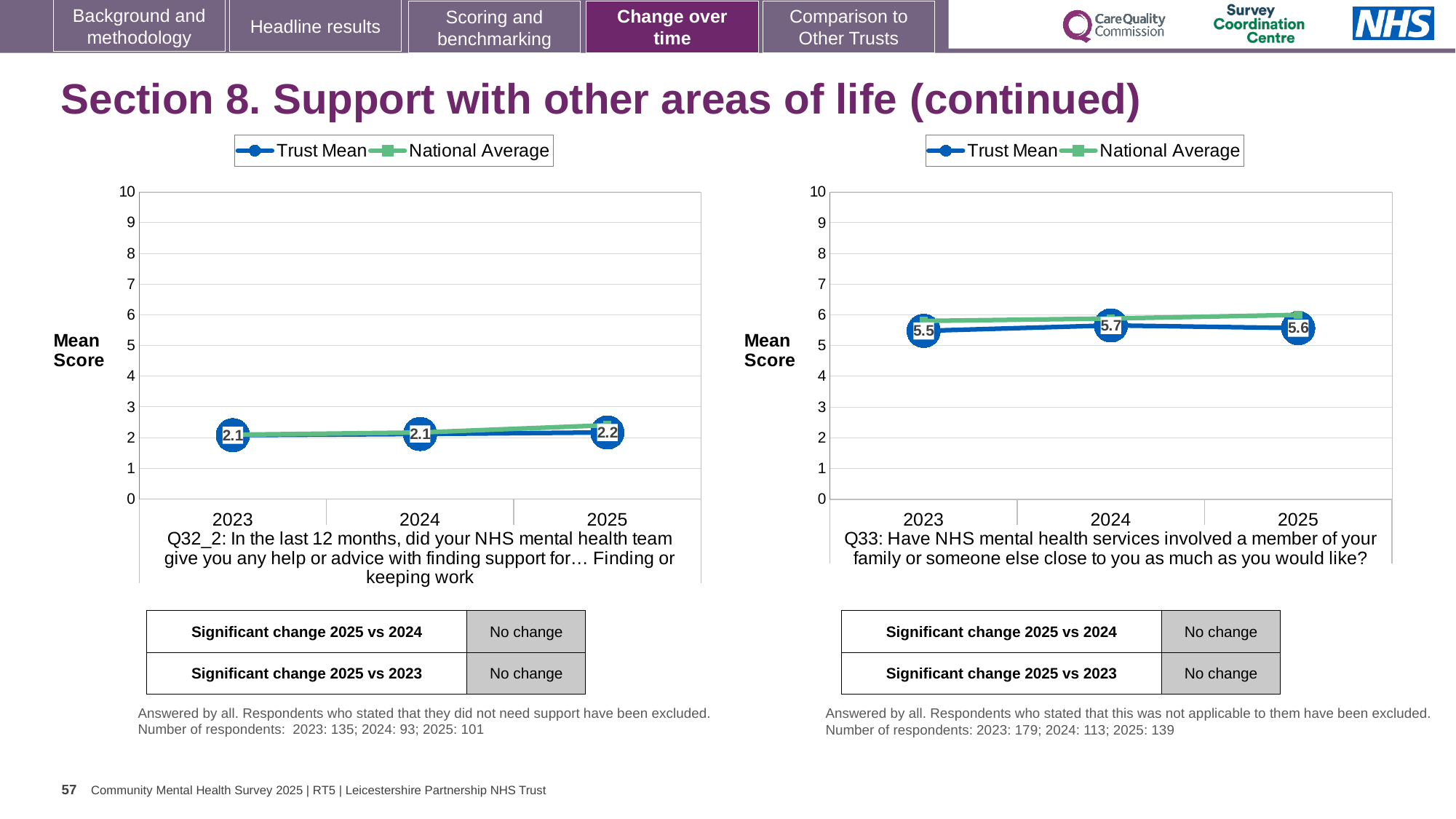
How many years are plotted on the x axis of the left chart (Q32_2)? 3 In the left chart (Q32_2), what is the Trust Mean for 2023? 2.1 In the right chart (Q33), what is the Trust Mean for 2024? 5.7 In the right chart (Q33), what is the Trust Mean for 2023? 5.5 What kind of chart is the left chart (Q32_2)? Line chart In the right chart (Q33), which year has the lowest Trust Mean? 2023 In the right chart (Q33), is the Trust Mean for 2025 greater or less than 5? greater In the left chart (Q32_2), is the Trust Mean for 2025 greater or less than 3? less In the left chart (Q32_2), what is the Trust Mean for 2025? 2.2 How many series does the legend of the right chart (Q33) list? 2 In the right chart (Q33), which year has the highest Trust Mean? 2024 In the right chart (Q33), what is the difference between the Trust Mean for 2024 and 2023? 0.2